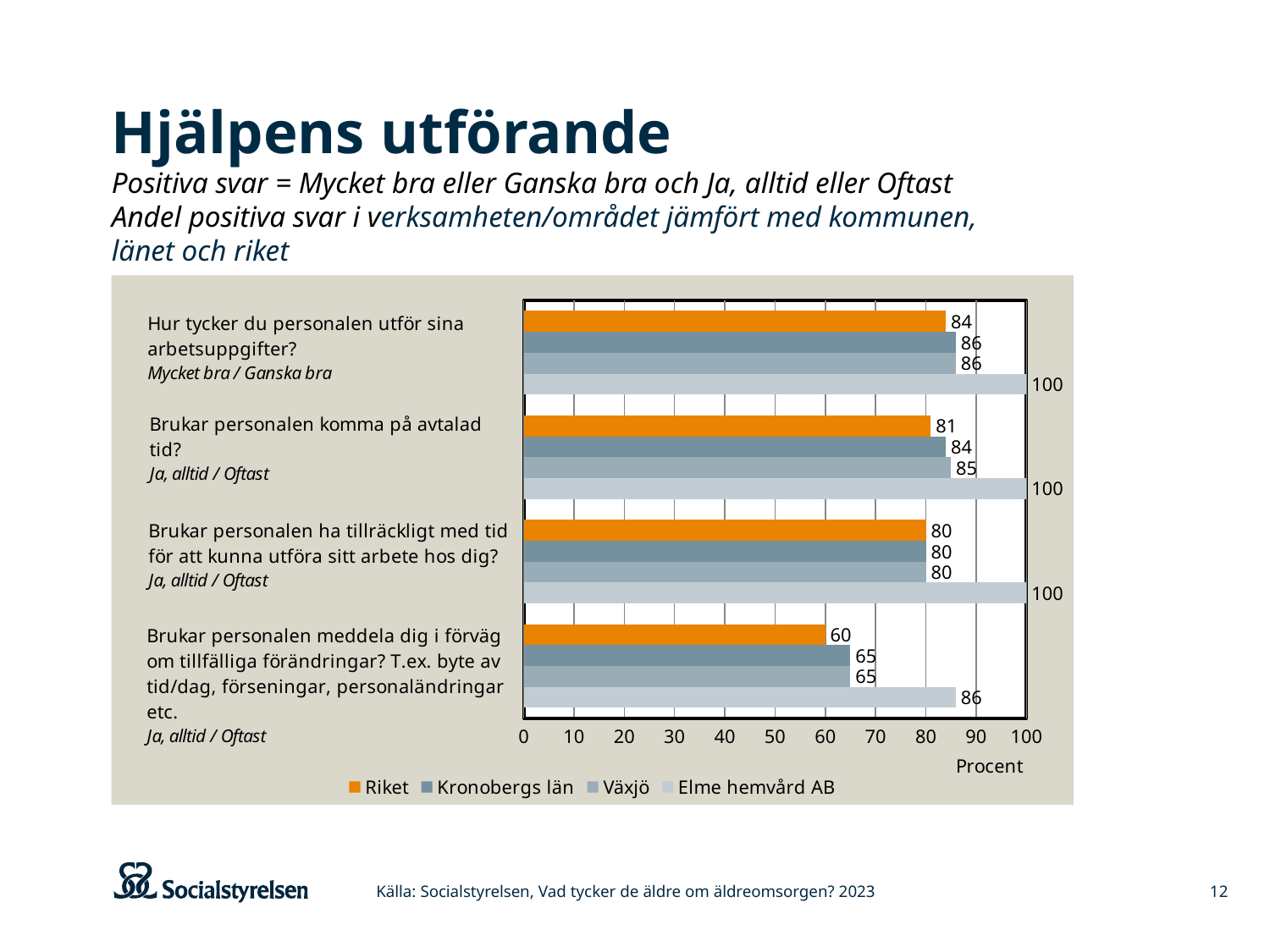
What is the value for Riket on the question "Hur tycker du personalen utför sina arbetsuppgifter?"? 84 What is the value for Kronobergs län on the question "Brukar personalen ha tillräckligt med tid för att kunna utföra sitt arbete hos dig?"? 80 What kind of chart is shown on the slide? bar chart For Riket, which question has the lowest value? Brukar personalen meddela dig i förväg om tillfälliga förändringar? What is the value for Växjö on the question "Brukar personalen meddela dig i förväg om tillfälliga förändringar?"? 65 How many questions (categories) are shown on the chart? 4 On the question "Brukar personalen komma på avtalad tid?", which is larger: Riket or Växjö? Växjö What is the value for Elme hemvård AB on the question "Brukar personalen komma på avtalad tid?"? 100 What is the difference between Elme hemvård AB and Riket on the question "Brukar personalen meddela dig i förväg om tillfälliga förändringar?"? 26 On the question "Brukar personalen meddela dig i förväg om tillfälliga förändringar?", which series has the highest value? Elme hemvård AB What is the label on the horizontal axis of the chart? Procent How many series does the legend list? 4